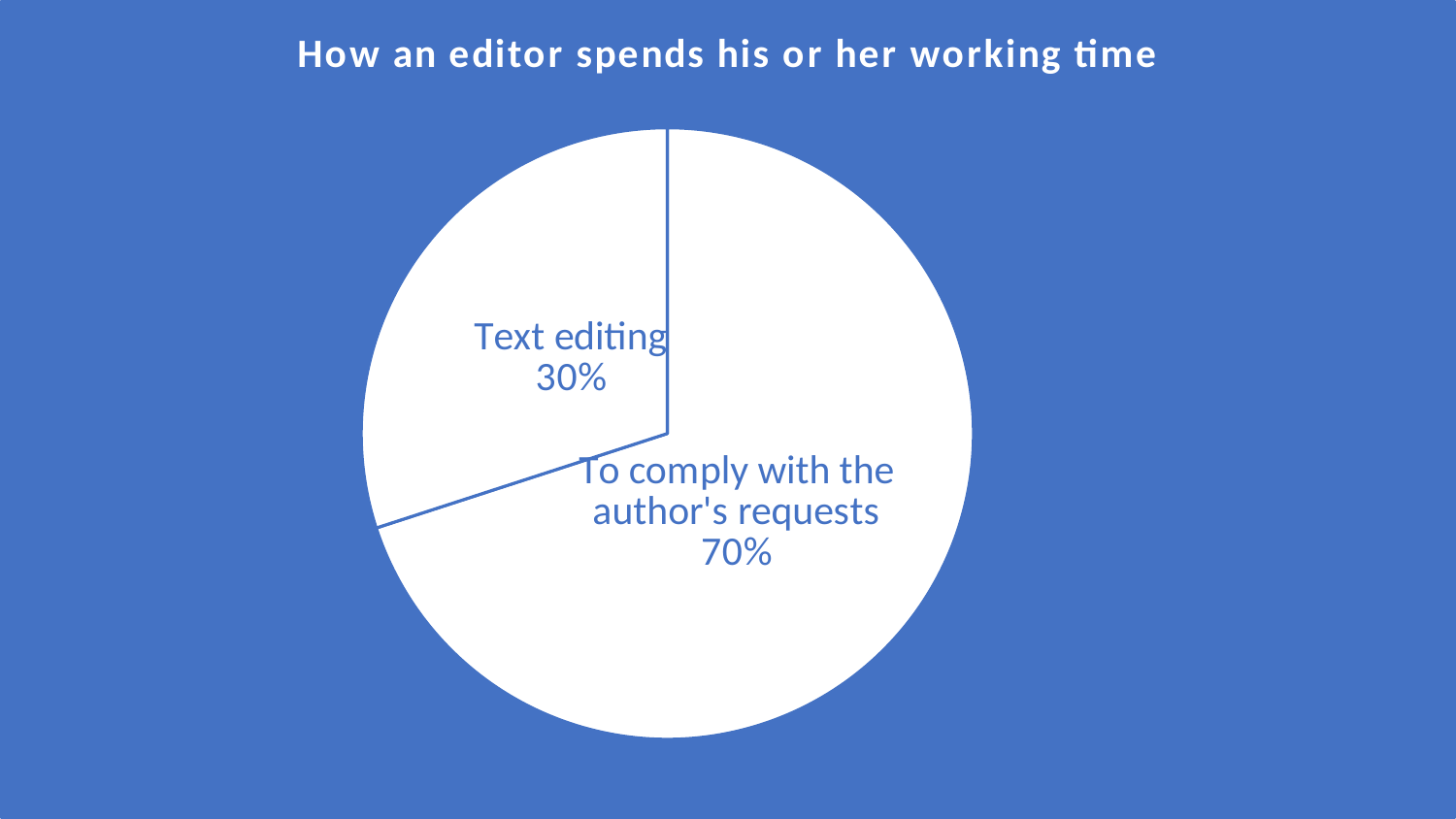
Which is larger, the Text editing slice or the To comply with the author's requests slice? To comply with the author's requests Which slice of the pie is the largest? To comply with the author's requests What share of the pie is labelled To comply with the author's requests? 70% What is the total of the two slice percentages shown? 100% What kind of chart is shown on the slide? Pie chart Which slice of the pie is the smallest? Text editing How many slices does the pie chart have? 2 What colour are the slices of the pie chart? White What is the difference in percentage points between the To comply with the author's requests slice and the Text editing slice? 40 percentage points What share of the pie is labelled Text editing? 30% What is the title of the chart? How an editor spends his or her working time